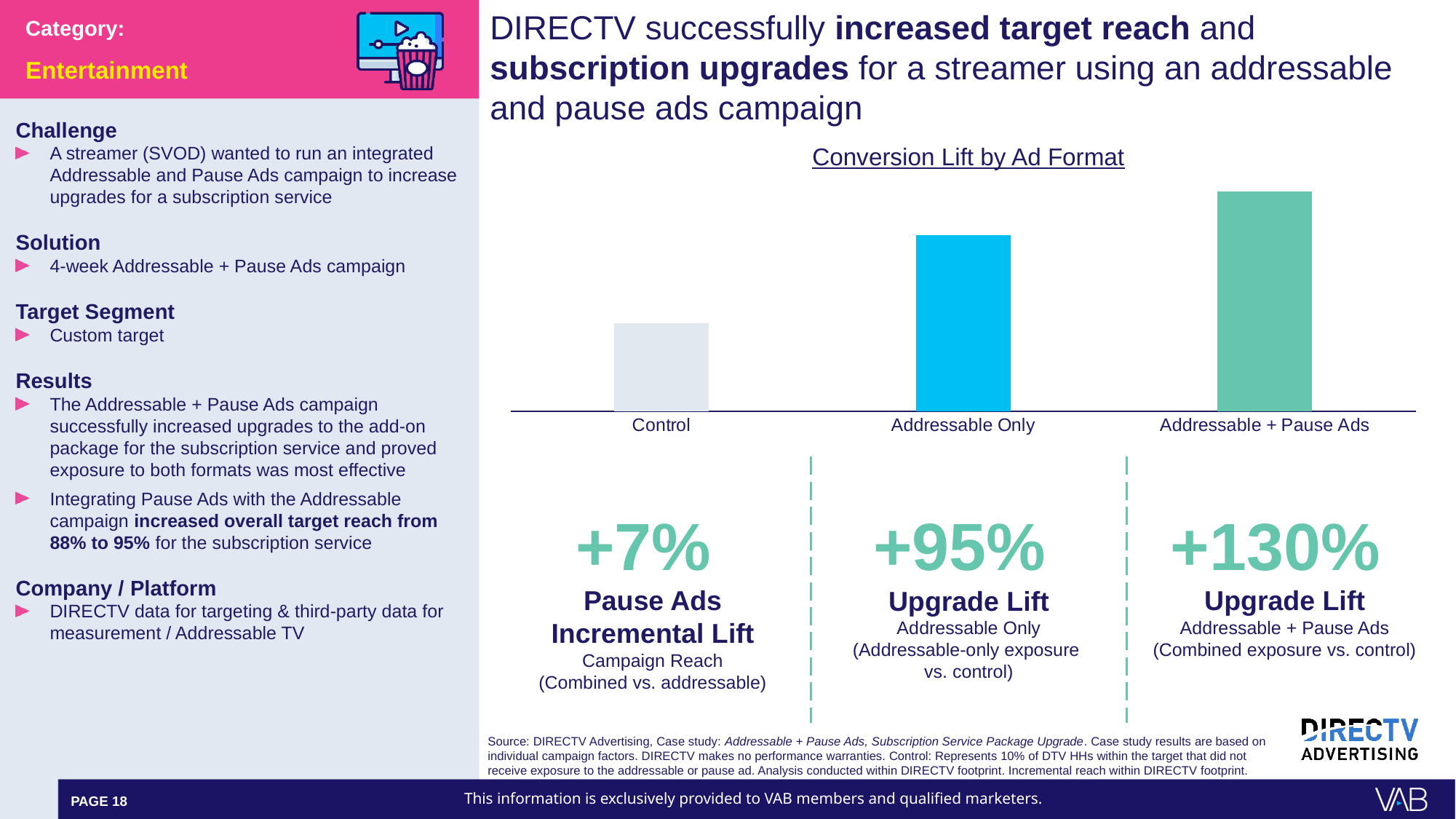
Which category has the highest bar in the "Conversion Lift by Ad Format" chart? Addressable + Pause Ads What kind of chart is shown under the title "Conversion Lift by Ad Format"? bar chart In the "Conversion Lift by Ad Format" chart, which bar is taller: Addressable Only or Control? Addressable Only What are the three category labels along the x axis of the "Conversion Lift by Ad Format" chart, from left to right? Control, Addressable Only, Addressable + Pause Ads Which category is plotted in the middle position of the "Conversion Lift by Ad Format" chart? Addressable Only Which category has the lowest bar in the "Conversion Lift by Ad Format" chart? Control How many categories are plotted in the "Conversion Lift by Ad Format" chart? 3 In the "Conversion Lift by Ad Format" chart, which bar is taller: Addressable Only or Addressable + Pause Ads? Addressable + Pause Ads Do the bars in the "Conversion Lift by Ad Format" chart rise or fall from left to right? rise What is the title of the chart on the slide? Conversion Lift by Ad Format